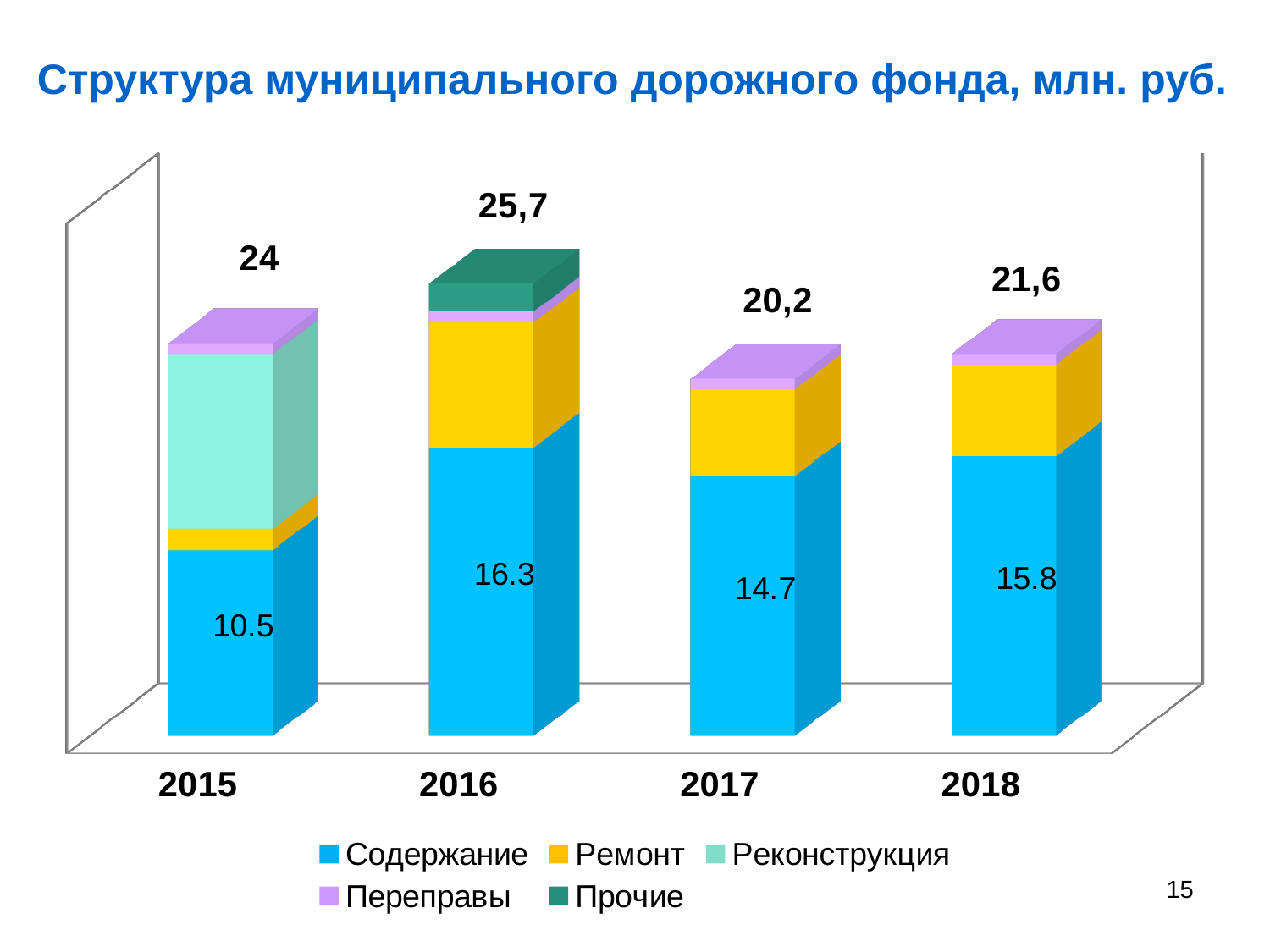
What is the value for Содержание in 2015? 10.5 What is the total of the stacked bar for 2017? 20,2 How many series does the legend list? 5 Which is larger, the Содержание value for 2018 or for 2017? 2018 Which year has the lowest total? 2017 What is the value for Содержание in 2016? 16.3 Which year has the highest total? 2016 How many years are shown on the x axis? 4 What is the total of the stacked bar for 2018? 21,6 What is the difference between the Содержание values for 2016 and 2015? 5.8 What kind of chart is shown on the slide? Stacked bar chart Which year has the lowest value for Содержание? 2015